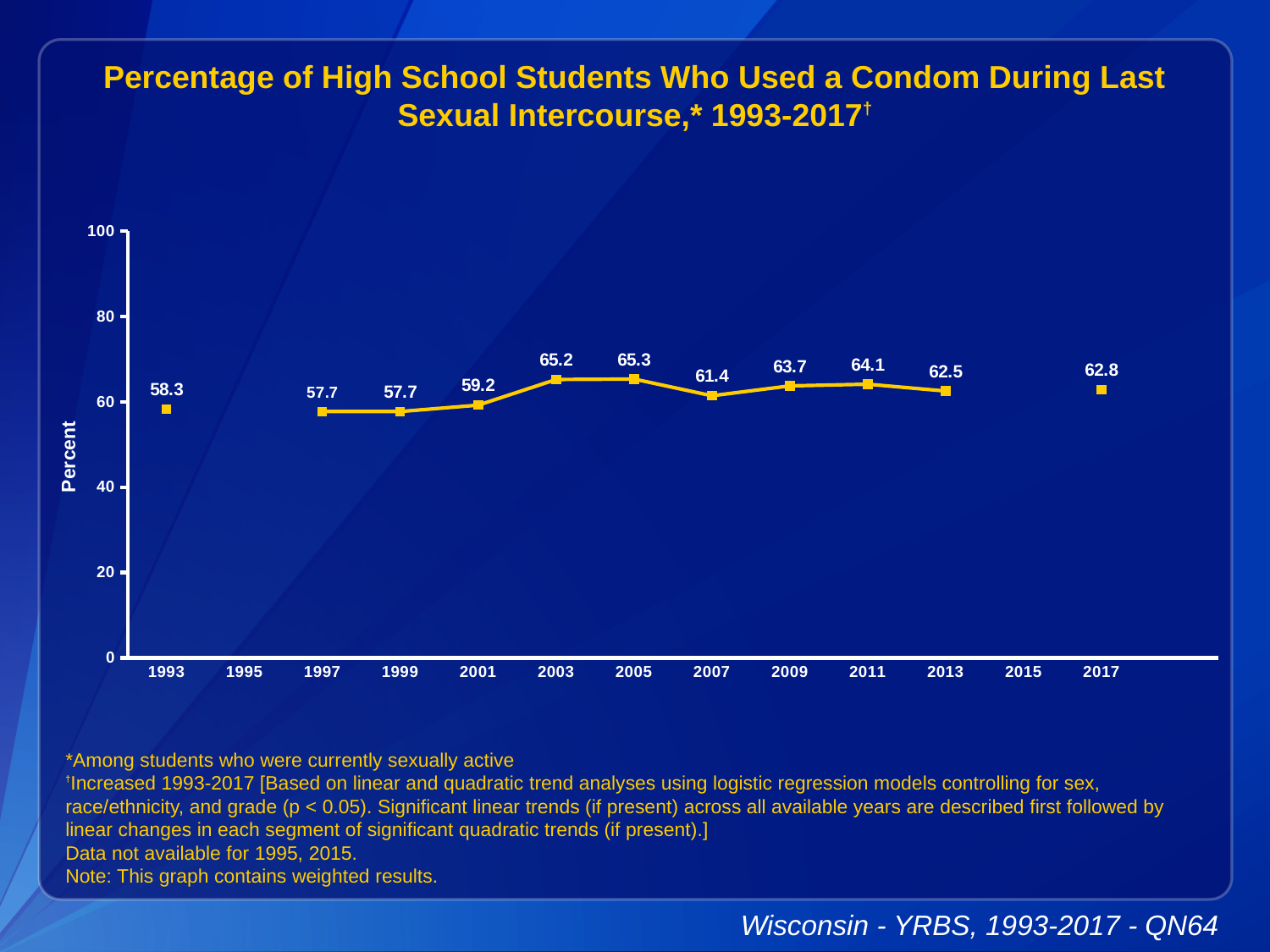
How many years have data points plotted on the chart? 11 Which is larger, the value for 2011 or the value for 2013? 2011 Is the value for 2003 greater or less than 60? greater What value is shown for 2007? 61.4 Which year has the highest percentage? 2005 What is the difference between the values for 2005 and 2007? 3.9 What kind of chart is shown on the slide? line chart What value is shown for 2017? 62.8 Which years share the lowest percentage? 1997 and 1999 What is the label on the y axis? Percent What is the difference between the values for 2017 and 1993? 4.5 What was the percentage of high school students who used a condom during last sexual intercourse in 1993? 58.3